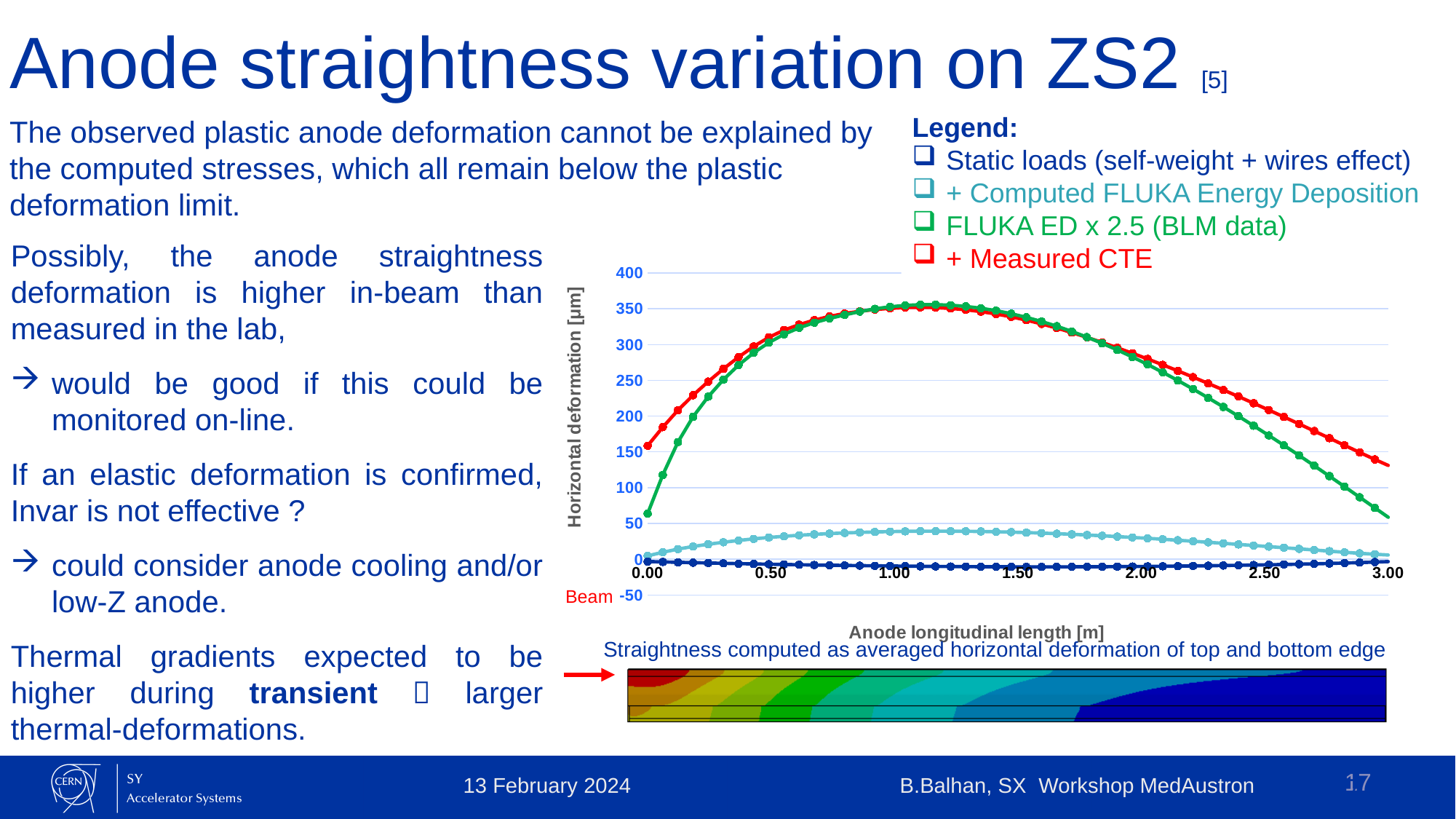
What kind of chart is shown on the slide? line chart Is the value of the '+ Measured CTE' series at 0.00 m greater or less than 100? greater What is the label of the x axis of the chart? Anode longitudinal length [m] How many series does the legend list for the chart? 4 Is the peak value of the 'FLUKA ED x 2.5 (BLM data)' series greater or less than 300? greater Is the highest value of the '+ Computed FLUKA Energy Deposition' series greater or less than 50? less What is the label of the y axis of the chart? Horizontal deformation [µm] Does the 'FLUKA ED x 2.5 (BLM data)' series rise or fall between 2.00 m and 3.00 m? fall At 3.00 m, which series has the larger value: '+ Measured CTE' or 'FLUKA ED x 2.5 (BLM data)'? + Measured CTE Which series has the lowest values across the whole anode length? Static loads (self-weight + wires effect)